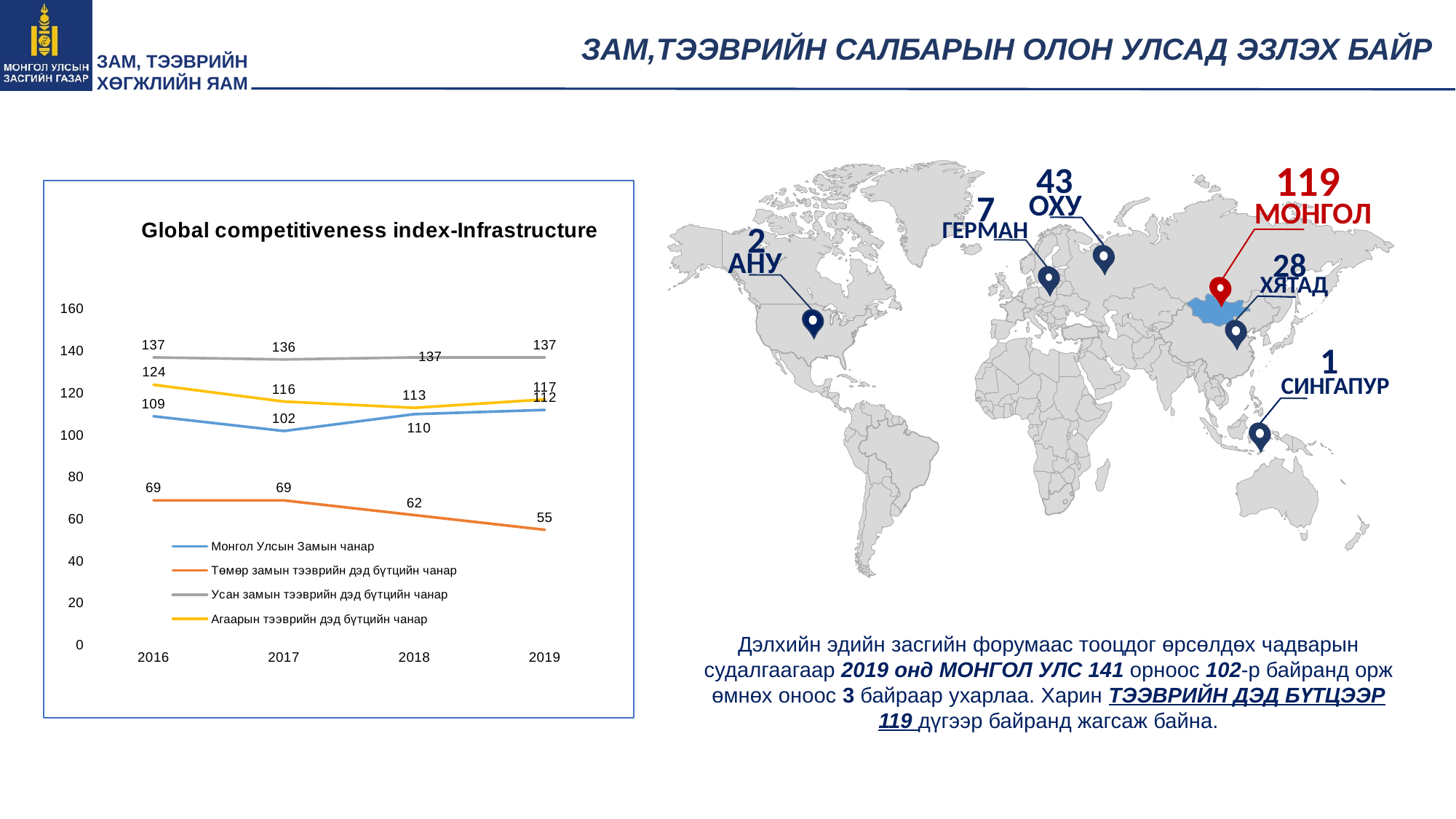
In the "Global competitiveness index-Infrastructure" chart, which series has the lowest value in 2018? Төмөр замын тээврийн дэд бүтцийн чанар In the "Global competitiveness index-Infrastructure" chart, what is the difference between the 2016 and 2019 values of "Төмөр замын тээврийн дэд бүтцийн чанар"? 14 In the "Global competitiveness index-Infrastructure" chart, what is the value of "Төмөр замын тээврийн дэд бүтцийн чанар" in 2019? 55 How many series does the legend of the "Global competitiveness index-Infrastructure" chart list? 4 In the "Global competitiveness index-Infrastructure" chart, what is the value of "Агаарын тээврийн дэд бүтцийн чанар" in 2016? 124 In the "Global competitiveness index-Infrastructure" chart, what is the value of "Монгол Улсын Замын чанар" in 2017? 102 How many years are shown on the x axis of the "Global competitiveness index-Infrastructure" chart? 4 What kind of chart is "Global competitiveness index-Infrastructure"? line chart In the "Global competitiveness index-Infrastructure" chart, does "Төмөр замын тээврийн дэд бүтцийн чанар" rise or fall from 2017 to 2019? fall In the "Global competitiveness index-Infrastructure" chart, which is larger in 2018: "Агаарын тээврийн дэд бүтцийн чанар" or "Монгол Улсын Замын чанар"? Агаарын тээврийн дэд бүтцийн чанар In the "Global competitiveness index-Infrastructure" chart, which series has the highest value in 2019? Усан замын тээврийн дэд бүтцийн чанар What colour is the line for "Усан замын тээврийн дэд бүтцийн чанар" in the "Global competitiveness index-Infrastructure" chart? gray